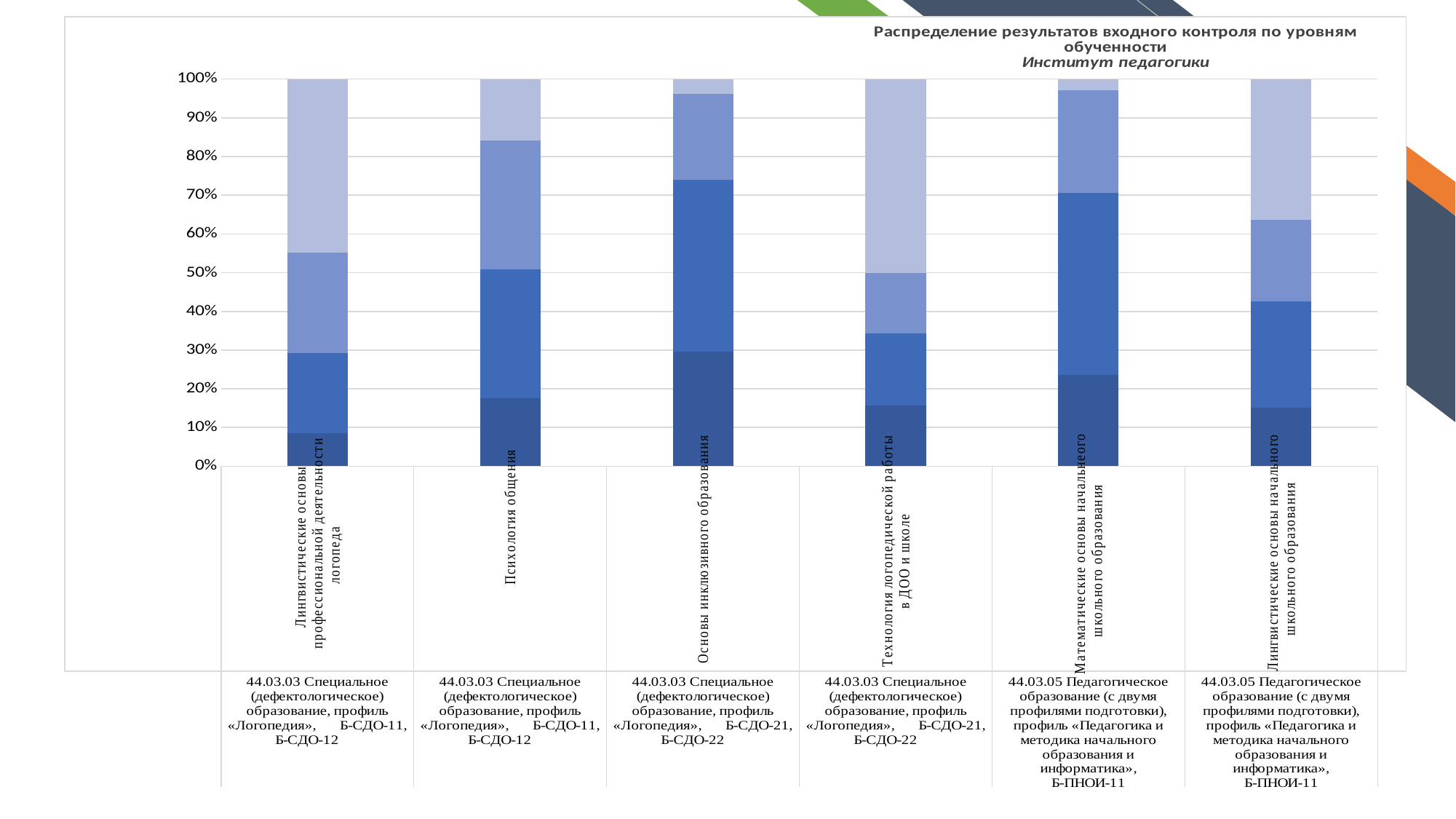
Is the top of the darkest (bottom) segment for Психология общения greater or less than 10%? greater Is the top of the darkest (bottom) segment for Лингвистические основы профессиональной деятельности логопеда greater or less than 10%? less Is the top of the third segment for Математические основы начального школьного образования greater or less than 90%? greater Which discipline has the smallest darkest (bottom) segment? Лингвистические основы профессиональной деятельности логопеда What kind of chart is shown on the slide? Stacked bar chart Which discipline has the largest lightest (top) segment? Технология логопедической работы в ДОО и школе What is the title of the chart? Распределение результатов входного контроля по уровням обученности Институт педагогики Which discipline has the largest darkest (bottom) segment? Основы инклюзивного образования How many stacked segments does each bar in the chart contain? 4 How many bars (disciplines) are plotted in the chart? 6